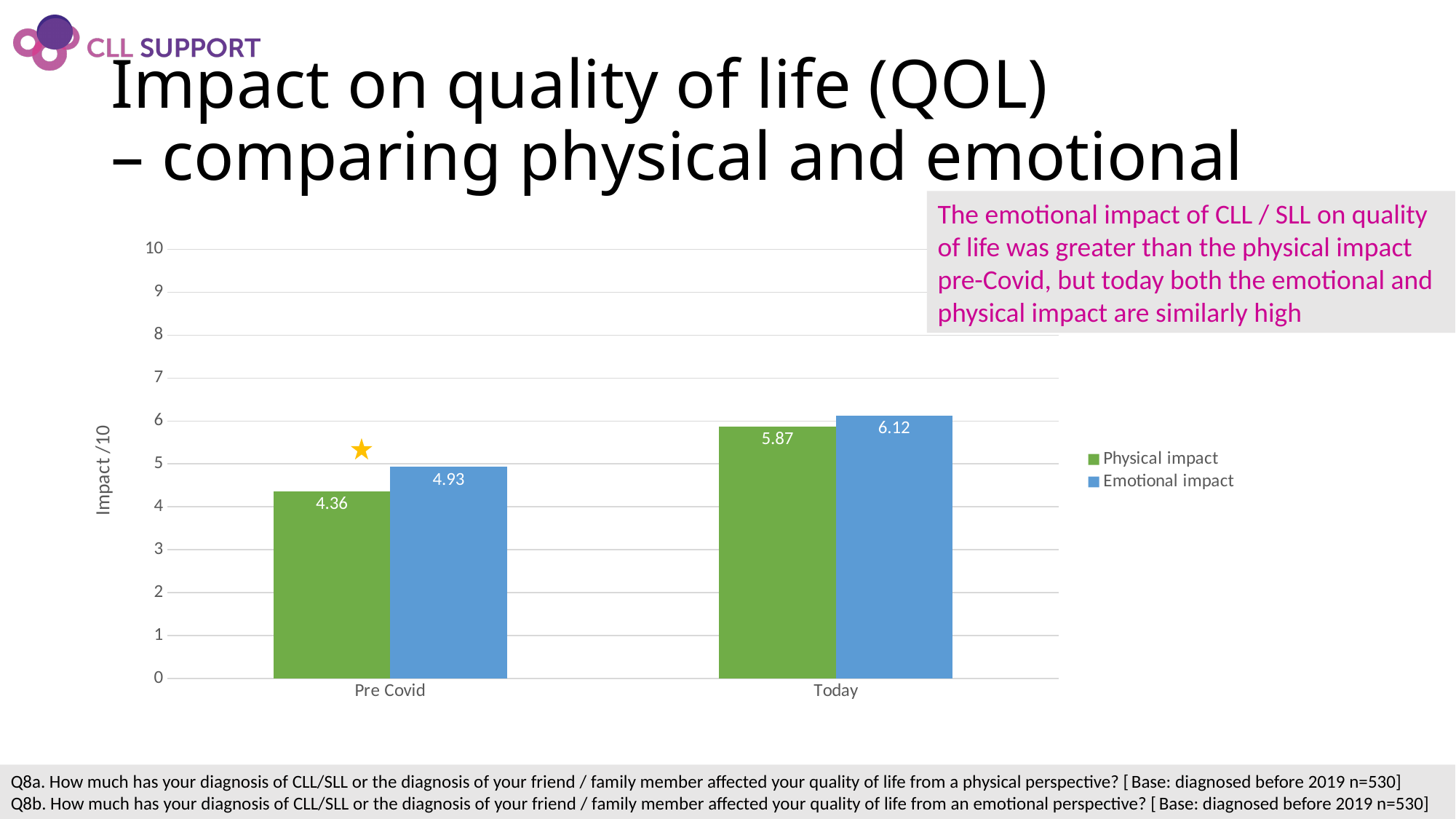
What is the difference between the Emotional impact and Physical impact values for Pre Covid? 0.57 What is the Physical impact value for Pre Covid? 4.36 Which category has the highest Emotional impact value? Today What is the difference between the Physical impact values for Today and Pre Covid? 1.51 What is the Emotional impact value for Pre Covid? 4.93 How many series does the legend list? 2 What kind of chart is shown on the slide? Bar chart What is the Physical impact value for Today? 5.87 What is the Emotional impact value for Today? 6.12 Which category has the lowest Physical impact value? Pre Covid Which is larger for Today: Physical impact or Emotional impact? Emotional impact How many categories are shown on the x axis? 2